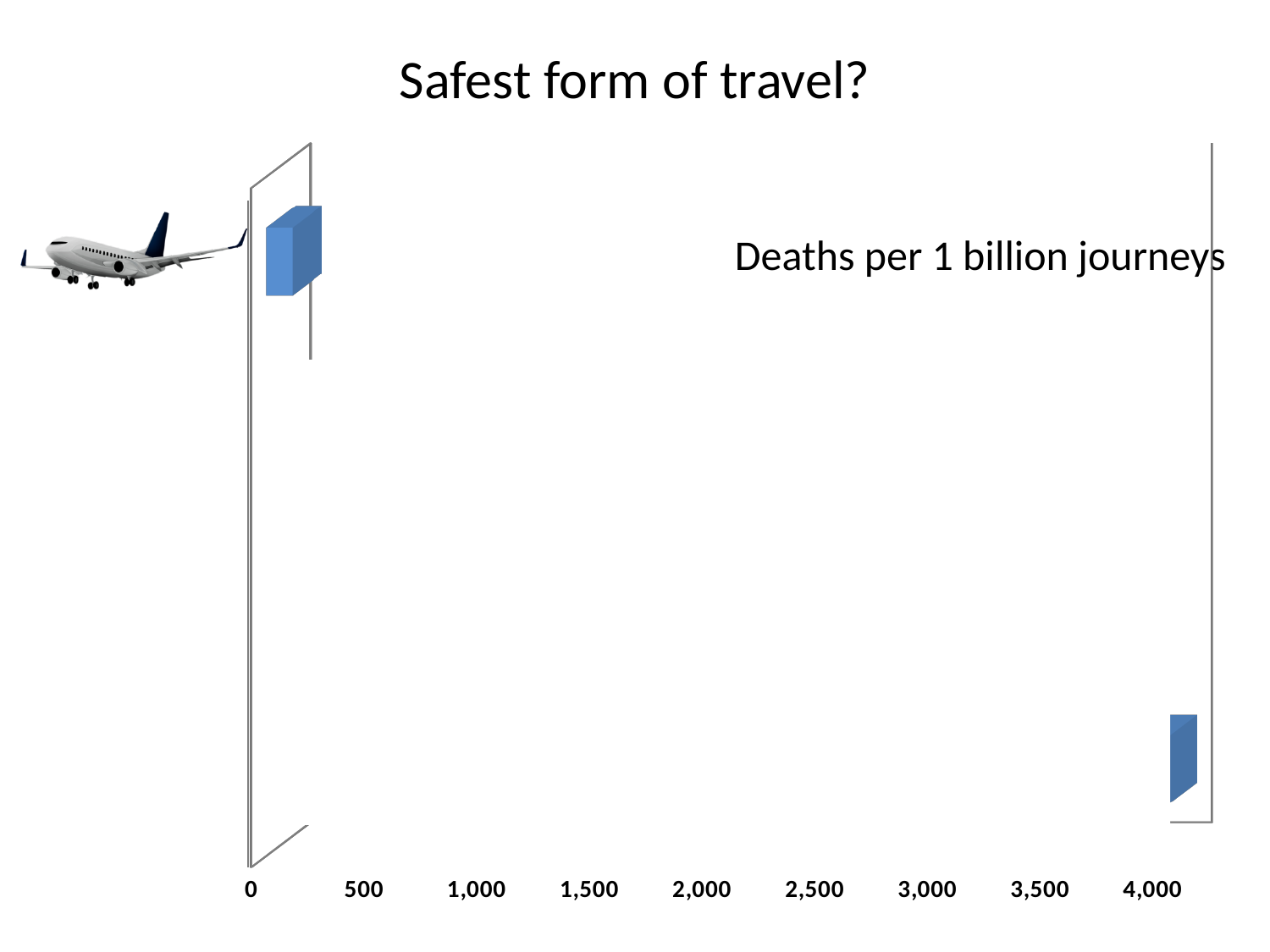
What is the title of the slide containing the chart? Safest form of travel? Which bar has the lowest value in the chart? the top bar Which bar is longer, the top bar or the bottom bar? the bottom bar What measure does the text on the chart say the bars represent? Deaths per 1 billion journeys What kind of chart is shown on the slide? bar chart What is the largest tick value shown on the horizontal axis? 4,000 Is the value of the bottom bar greater or less than 3,500? greater Is the value of the top bar (next to the airplane image) greater or less than 500? less How many bars are plotted in the chart? 2